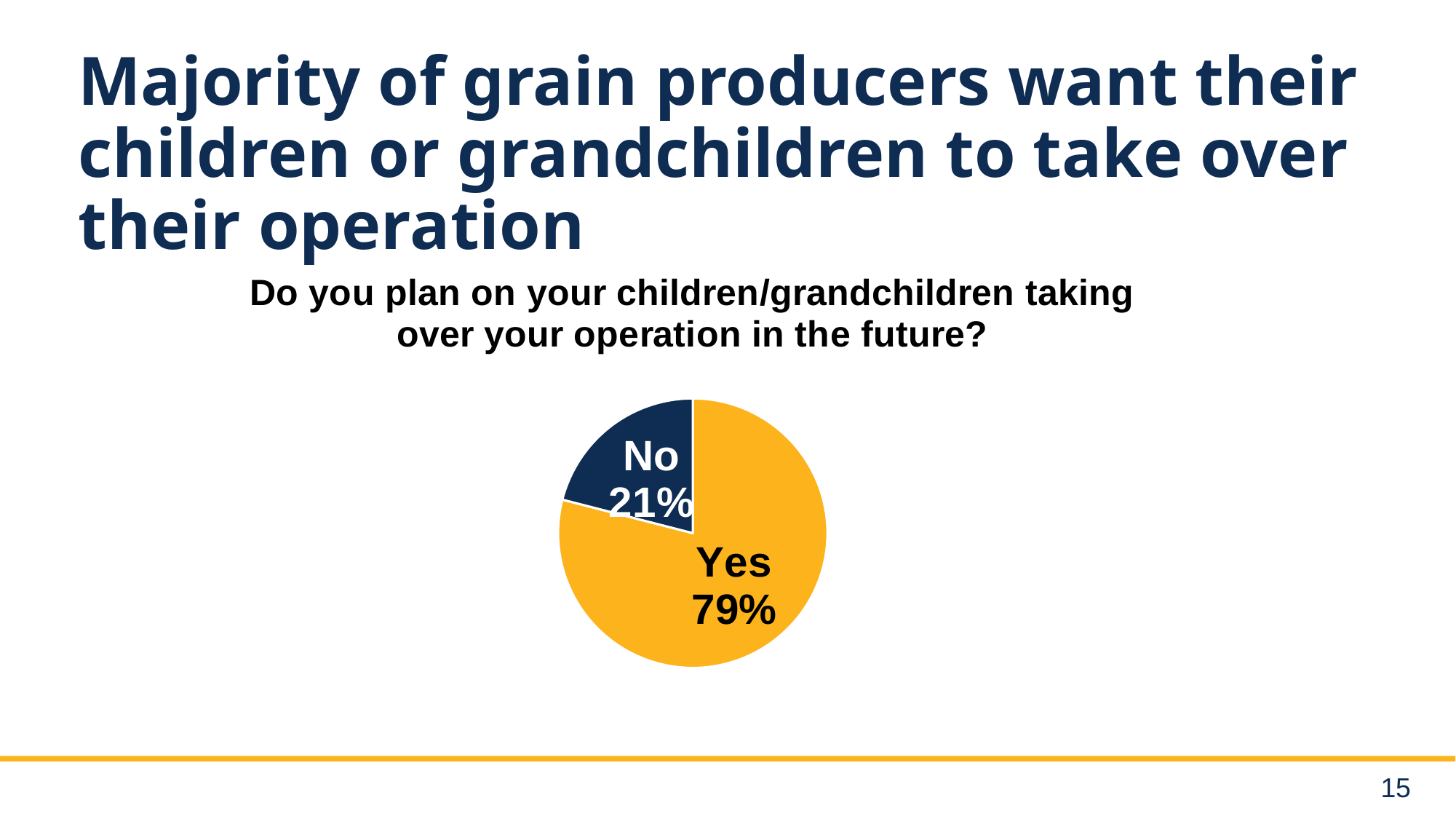
How many slices does the pie chart have? 2 What kind of chart is shown on the slide? Pie chart Which response has the largest share of the pie? Yes What is the difference in percentage points between the Yes and No shares? 58 What share of the pie does the Yes slice represent? 79% Which response has the smallest share of the pie? No Which is larger, the Yes share or the No share? Yes What colour is the Yes slice of the pie? Yellow What question does the chart title ask? Do you plan on your children/grandchildren taking over your operation in the future? What percentage of respondents answered No? 21% What percentage of respondents answered Yes? 79%